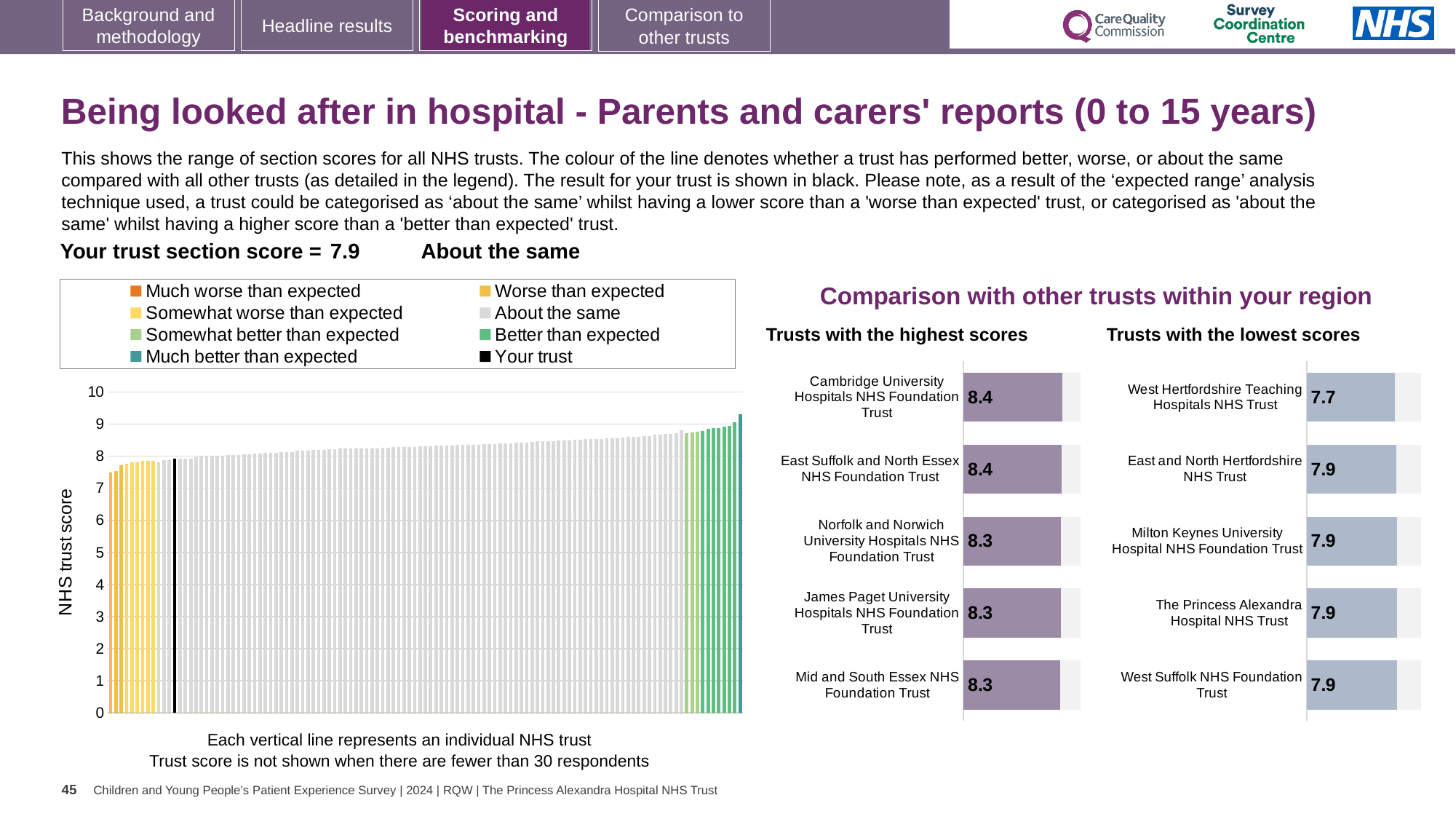
In the 'Trusts with the highest scores' chart, what is the score for Cambridge University Hospitals NHS Foundation Trust? 8.4 In the large chart on the left, do the trust scores rise or fall from left to right along the x axis? rise What kind of chart is the large chart on the left with the y-axis labelled 'NHS trust score'? bar chart In the large chart on the left, is the value for the black 'Your trust' bar greater or less than 5? greater In the large chart on the left, how many entries does the legend list? 8 Which is larger: the score for East Suffolk and North Essex NHS Foundation Trust in the 'Trusts with the highest scores' chart, or the score for West Hertfordshire Teaching Hospitals NHS Trust in the 'Trusts with the lowest scores' chart? East Suffolk and North Essex NHS Foundation Trust In the large chart on the left, what is the label on the y axis? NHS trust score In the 'Trusts with the highest scores' chart, what is the score for Mid and South Essex NHS Foundation Trust? 8.3 In the 'Trusts with the lowest scores' chart, what is the score for The Princess Alexandra Hospital NHS Trust? 7.9 In the 'Trusts with the lowest scores' chart, which trust has the lowest score? West Hertfordshire Teaching Hospitals NHS Trust In the 'Trusts with the highest scores' chart, what is the difference between the scores of Cambridge University Hospitals NHS Foundation Trust and Norfolk and Norwich University Hospitals NHS Foundation Trust? 0.1 In the 'Trusts with the highest scores' chart, how many trusts are shown? 5